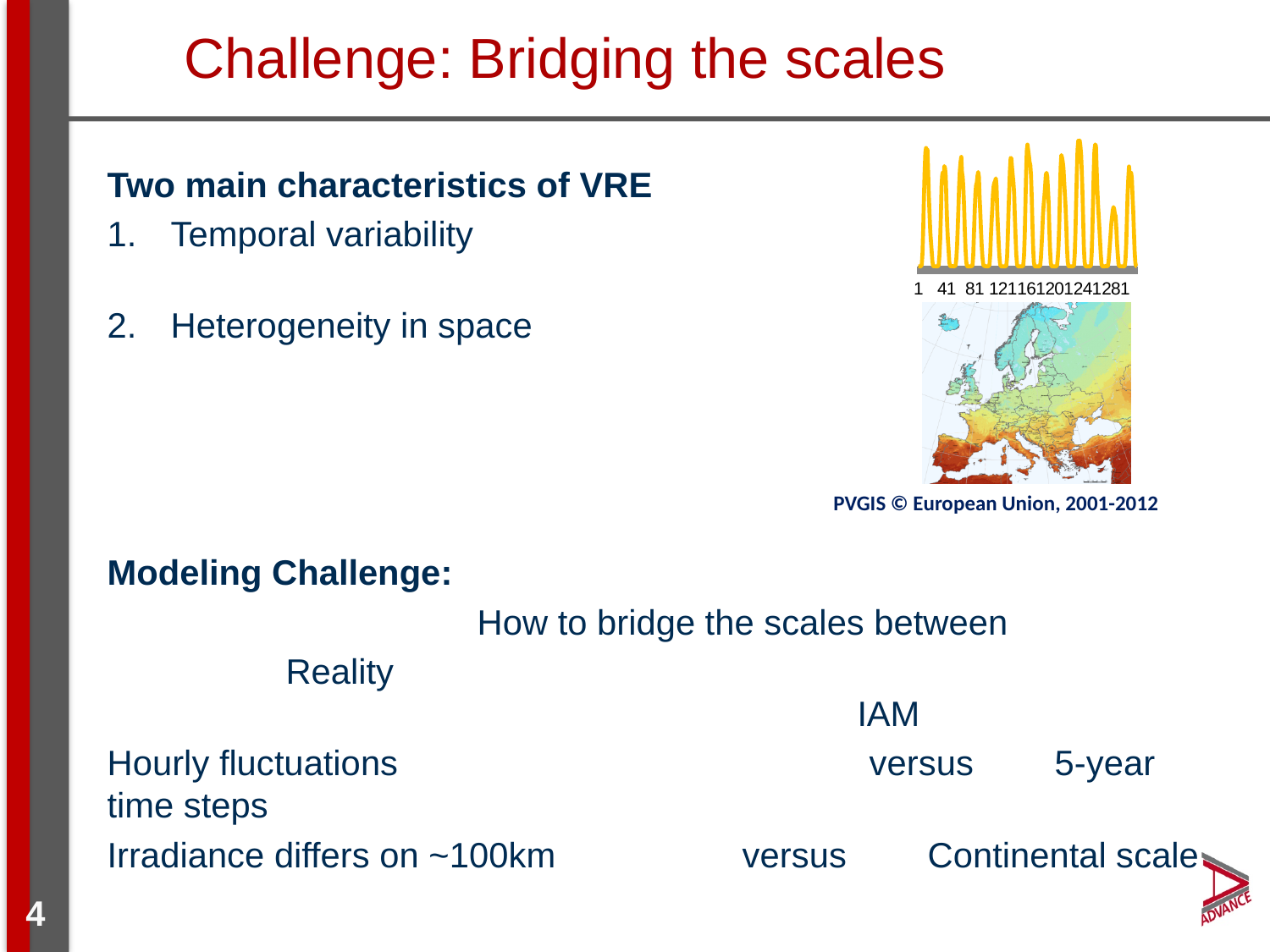
How many lines are plotted in the chart at the top right of the slide? 1 How many tick labels are printed on the x axis of the chart at the top right of the slide? 8 In the chart at the top right of the slide, what is the first label on the x axis? 1 In the chart at the top right of the slide, what is the last label on the x axis? 281 What kind of chart is shown at the top right of the slide, above the map? line chart Does the line in the chart at the top right of the slide show a steady rise, a steady fall, or repeated up-and-down fluctuations along the x axis? repeated up-and-down fluctuations